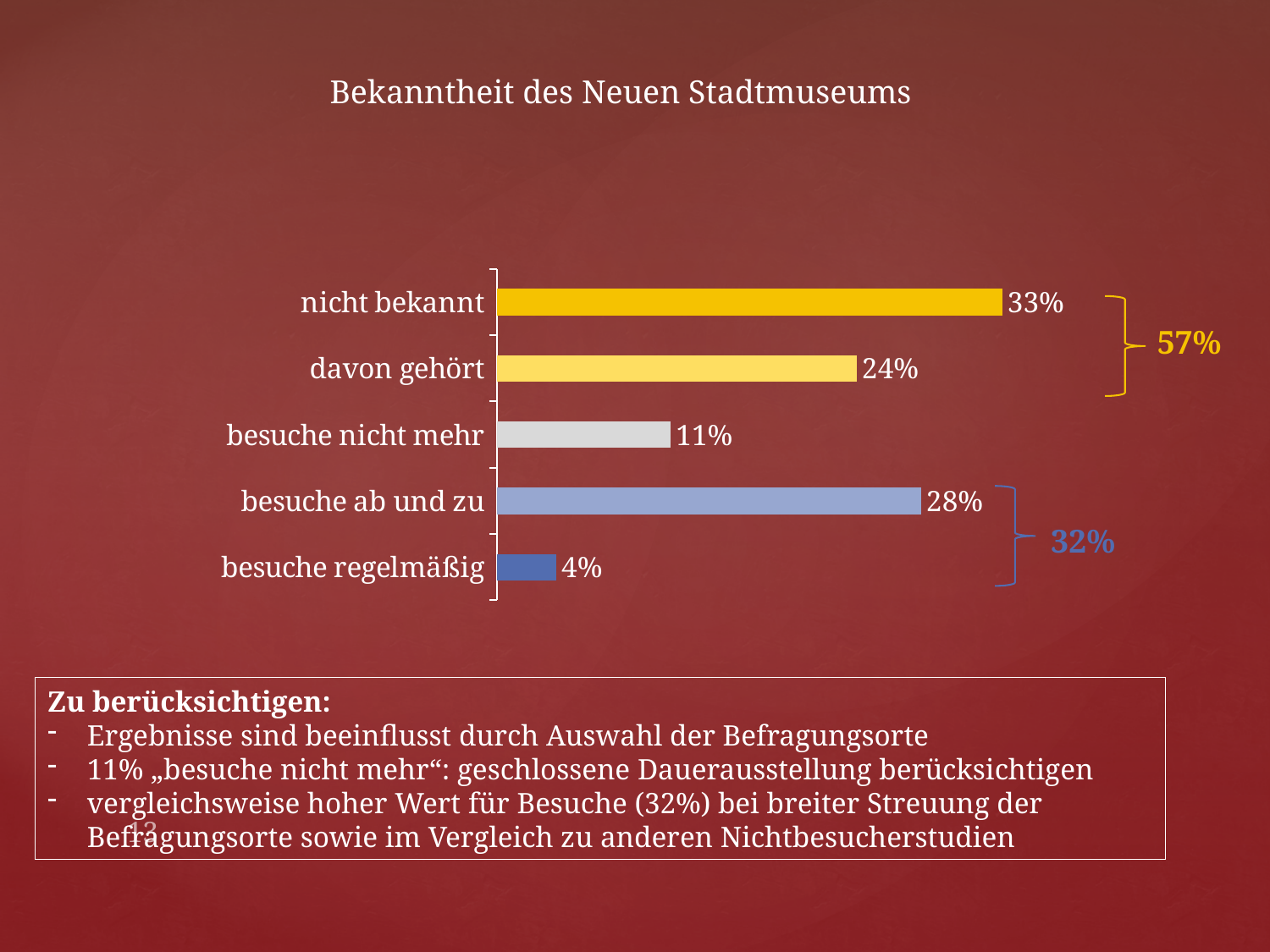
What is the title of the chart? Bekanntheit des Neuen Stadtmuseums How many categories are shown in the chart? 5 What is the value for "besuche nicht mehr"? 11% Which is larger, the value for "besuche ab und zu" or the value for "davon gehört"? besuche ab und zu What is the difference between the values for "nicht bekannt" and "davon gehört"? 9% What is the value for "besuche regelmäßig"? 4% What is the value for "nicht bekannt"? 33% What kind of chart is shown on the slide? bar chart Which category has the lowest value? besuche regelmäßig What is the value for "besuche ab und zu"? 28% Which category has the highest value? nicht bekannt What is the value for "davon gehört"? 24%